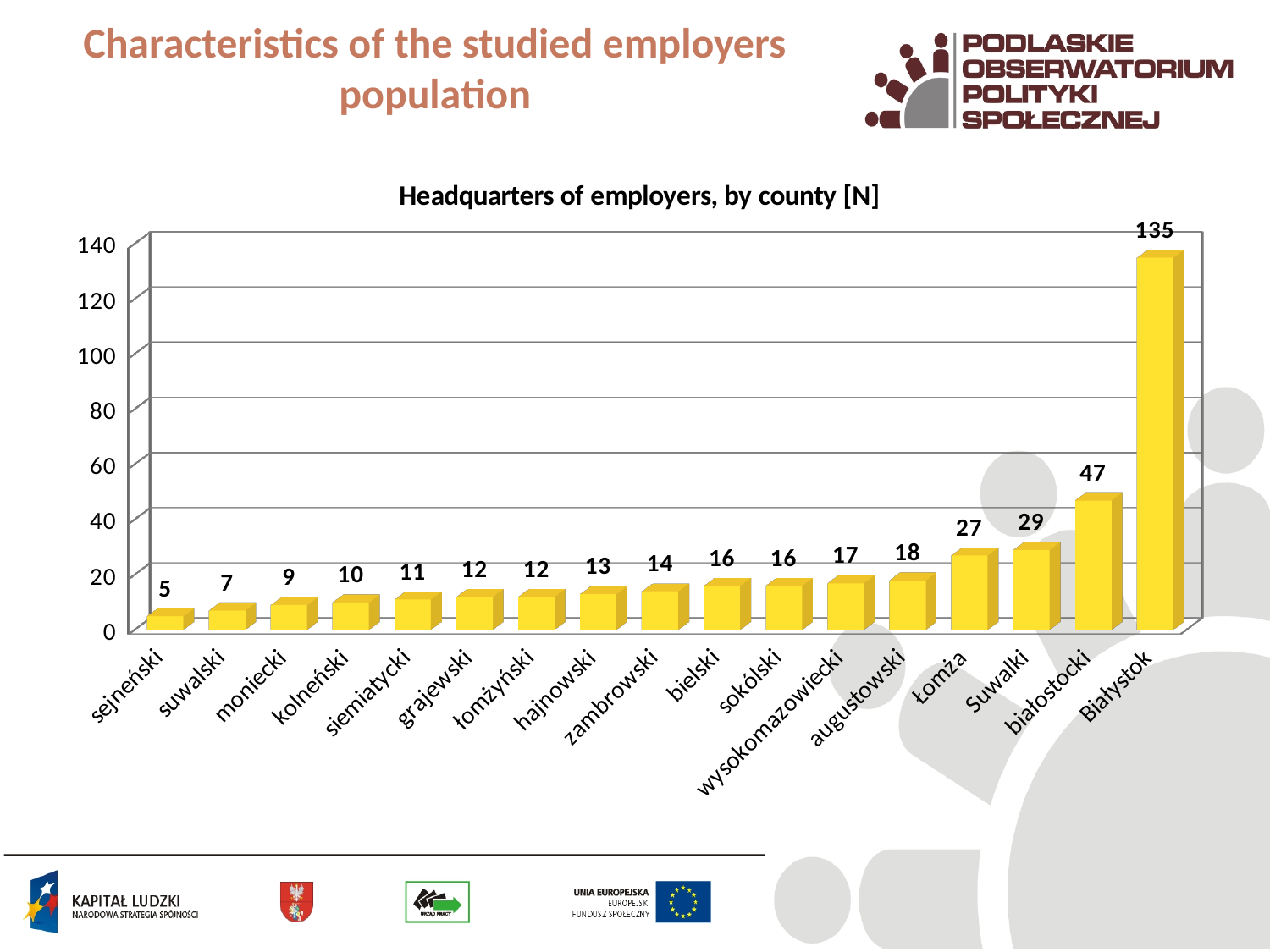
What is the value for białostocki? 47 Do the values rise or fall from left to right along the x axis? rise Which has a larger value, Łomża or Suwalki? Suwalki Which county has the highest value? Białystok What is the title of the chart? Headquarters of employers, by county [N] What is the value for wysokomazowiecki? 17 How many counties are shown on the x axis? 17 What kind of chart is this? bar chart What is the difference between the values for Białystok and białostocki? 88 Is the value for augustowski greater or less than 20? less What is the value for Białystok? 135 Which county has the lowest value? sejneński